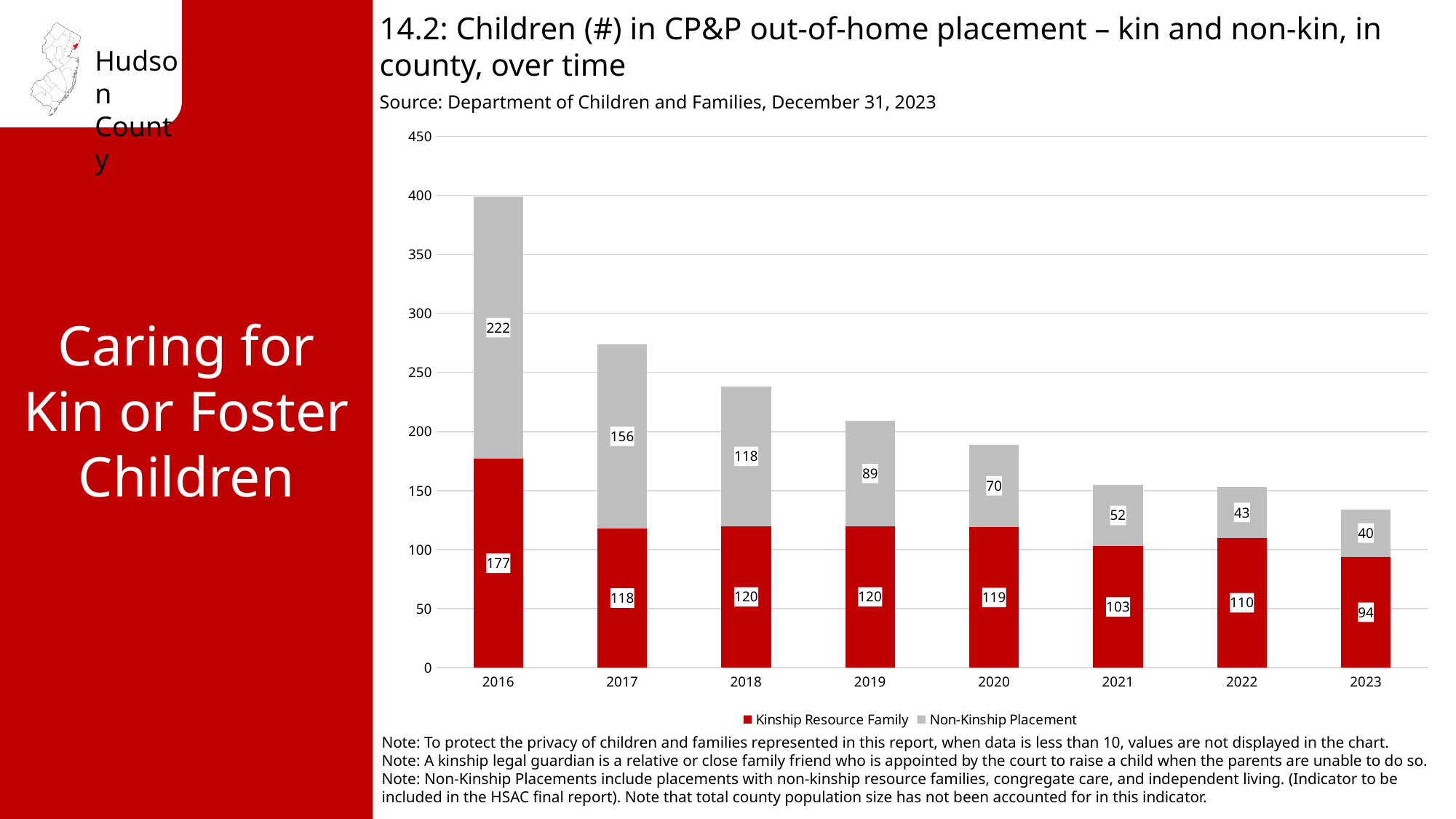
What is the Kinship Resource Family value for 2016? 177 Which year has the lowest Kinship Resource Family value? 2023 What is the difference between the Non-Kinship Placement values for 2016 and 2017? 66 Which year has the highest Non-Kinship Placement value? 2016 How many years are shown on the x axis? 8 What is the Non-Kinship Placement value for 2019? 89 Which is larger in 2021: Kinship Resource Family or Non-Kinship Placement? Kinship Resource Family What is the total of the stacked bar for 2016? 399 What is the total of the stacked bar for 2022? 153 What is the Non-Kinship Placement value for 2023? 40 How many series does the legend list? 2 What kind of chart is shown? Stacked bar chart